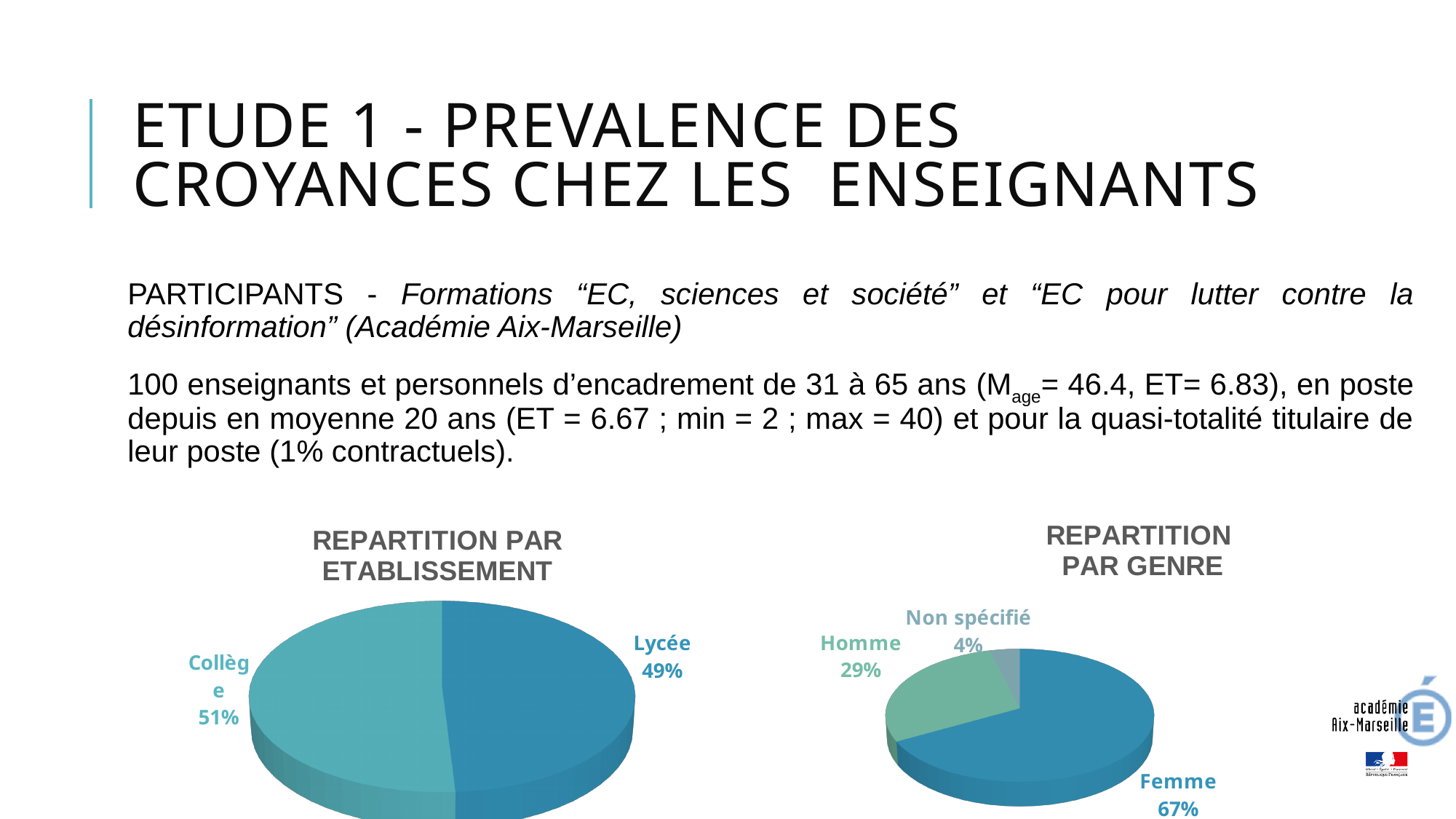
In the "REPARTITION PAR GENRE" chart, which category has the largest share? Femme In the "REPARTITION PAR GENRE" chart, what share does Femme have? 67% In the "REPARTITION PAR GENRE" chart, what is the difference in percentage points between Femme and Homme? 38 In the "REPARTITION PAR ETABLISSEMENT" chart, what share does Collège have? 51% In the "REPARTITION PAR GENRE" chart, is the share for Homme larger or smaller than the share for Femme? Smaller In the "REPARTITION PAR GENRE" chart, what share does Homme have? 29% In the "REPARTITION PAR GENRE" chart, which category has the smallest share? Non spécifié In the "REPARTITION PAR GENRE" chart, how many categories are shown? 3 In the "REPARTITION PAR GENRE" chart, what share is Non spécifié? 4% What type of chart is "REPARTITION PAR ETABLISSEMENT"? Pie chart In the "REPARTITION PAR ETABLISSEMENT" chart, what is the difference in percentage points between Collège and Lycée? 2 In the "REPARTITION PAR ETABLISSEMENT" chart, what share does Lycée have? 49%